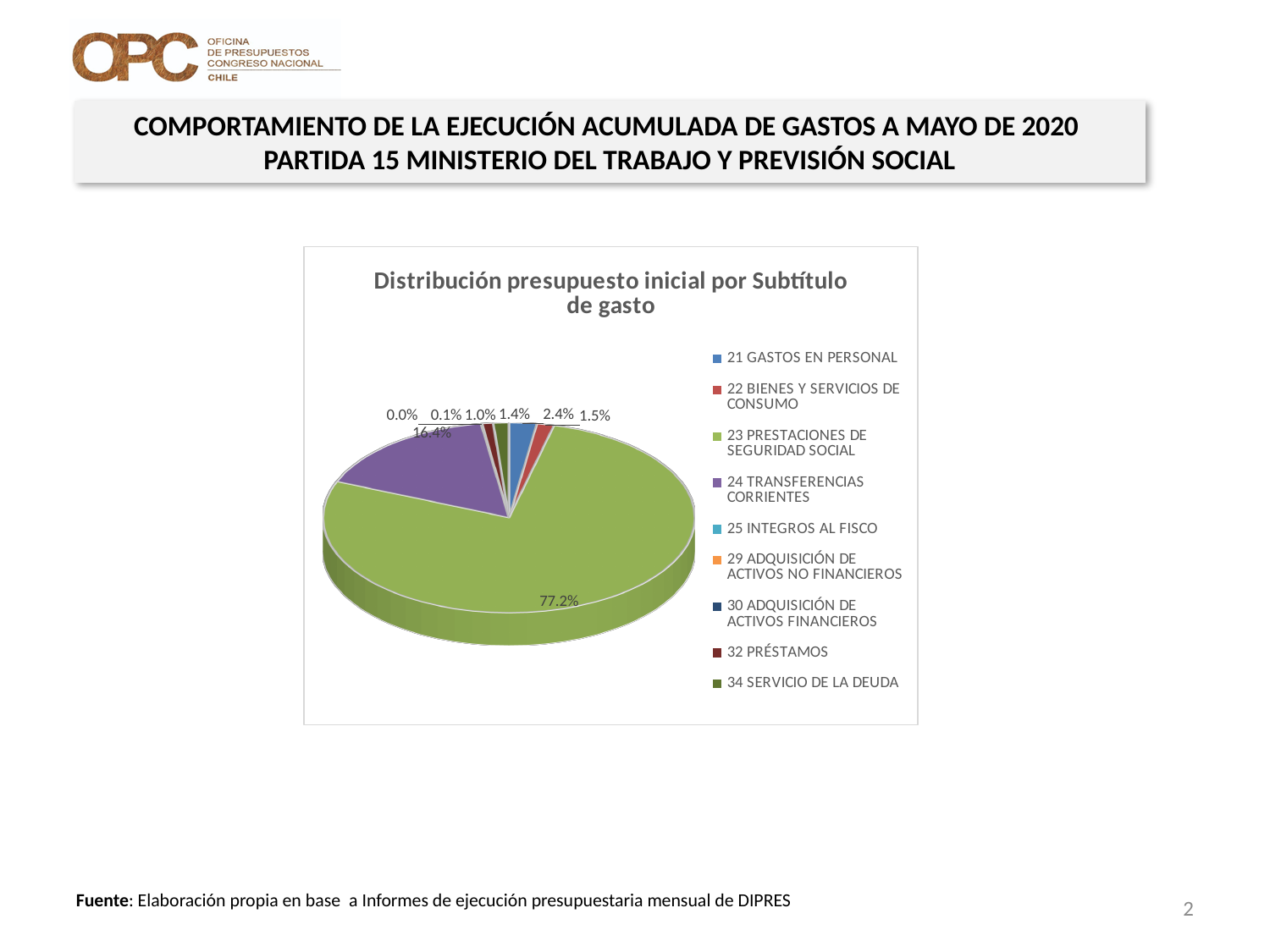
What share of the pie does 24 TRANSFERENCIAS CORRIENTES represent? 16.4% Which is larger, the share for 23 PRESTACIONES DE SEGURIDAD SOCIAL or for 24 TRANSFERENCIAS CORRIENTES? 23 PRESTACIONES DE SEGURIDAD SOCIAL What share of the pie does 23 PRESTACIONES DE SEGURIDAD SOCIAL represent? 77.2% What is the title of the chart? Distribución presupuesto inicial por Subtítulo de gasto By how many percentage points does the share of 23 PRESTACIONES DE SEGURIDAD SOCIAL exceed that of 24 TRANSFERENCIAS CORRIENTES? 60.8 How many entries does the chart legend list? 9 What colour is the largest slice of the pie? green What is the smallest percentage value printed as a data label on the pie? 0.0% Which subtítulo has the largest share of the pie? 23 PRESTACIONES DE SEGURIDAD SOCIAL Is the share for 23 PRESTACIONES DE SEGURIDAD SOCIAL greater or less than 50%? greater What kind of chart is shown on the slide? pie chart